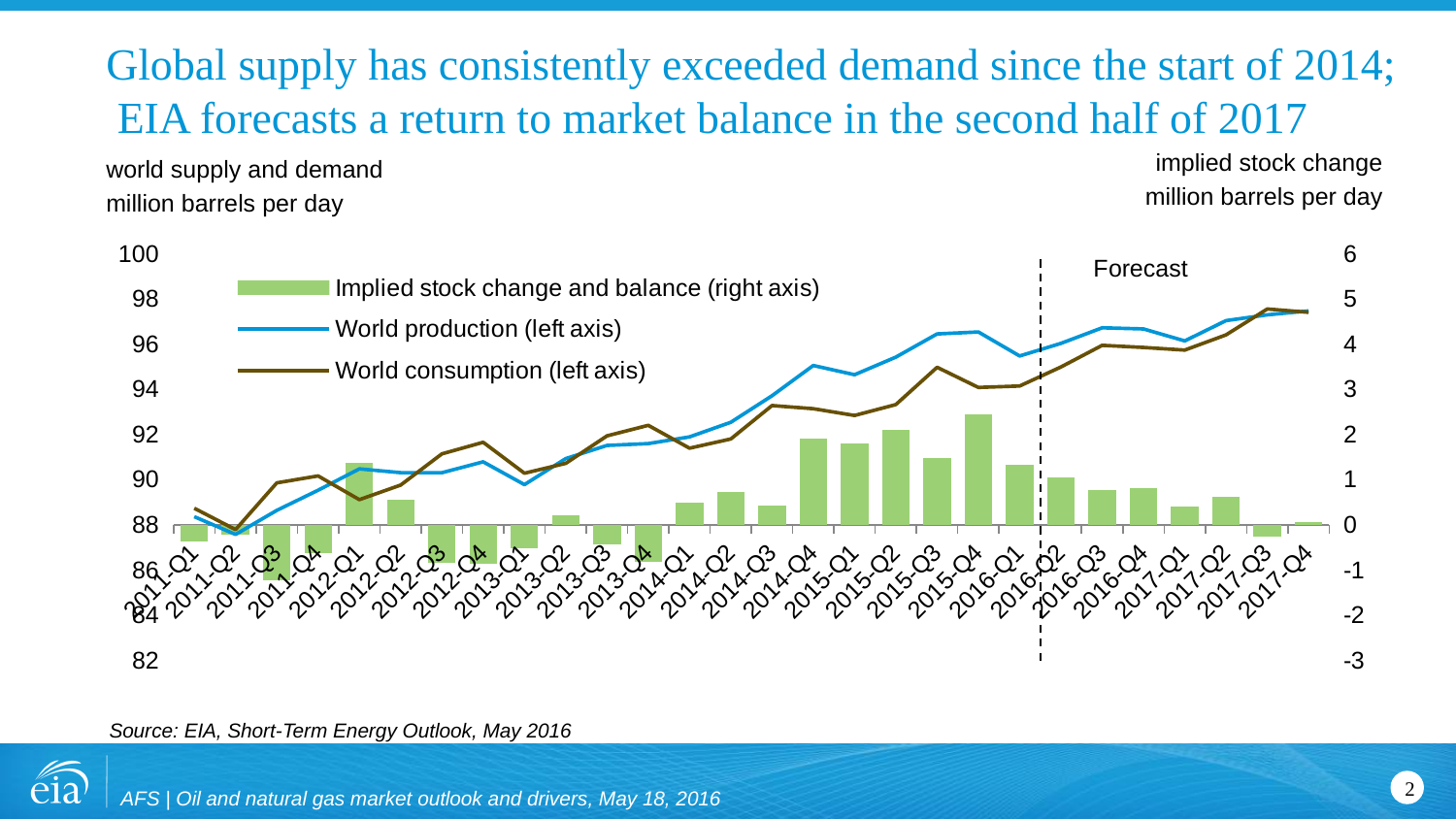
Is the implied stock change for 2015-Q4 greater or less than 2 million barrels per day? greater Is world production in 2017-Q4 greater or less than 96 million barrels per day? greater How many series does the legend list? 3 In 2015-Q4, which is larger: world production or world consumption? World production In which quarter is the implied stock change bar the highest? 2015-Q4 In which quarter is the implied stock change bar the lowest? 2011-Q3 How many quarters are shown along the x axis? 28 Is world consumption in 2014-Q1 greater or less than 90 million barrels per day? greater Does world production generally rise or fall from 2011-Q1 to 2017-Q4? Rise What kind of chart is this? Combined bar and line chart Which series is plotted on the right axis according to the legend? Implied stock change and balance